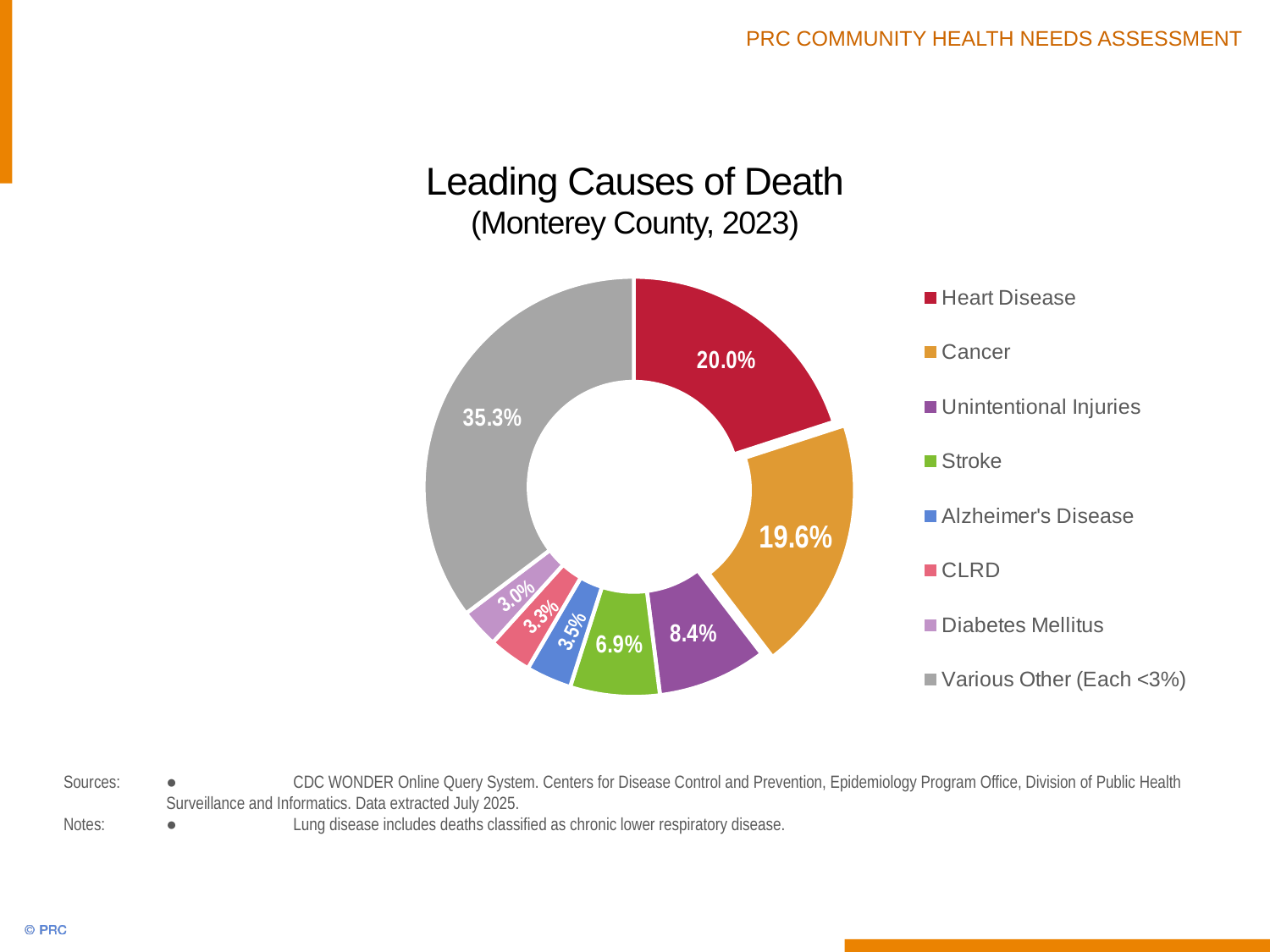
Which category has the largest share of the chart? Various Other (Each <3%) What is the difference between the Heart Disease share and the Cancer share? 0.4% What share of deaths is attributed to Heart Disease? 20.0% What percentage of deaths is attributed to Cancer? 19.6% What percentage is shown for Alzheimer's Disease? 3.5% What percentage is shown for Diabetes Mellitus? 3.0% Which is larger, the share for Unintentional Injuries or the share for Stroke? Unintentional Injuries What share of deaths is attributed to Stroke? 6.9% How many categories does the legend list? 8 What kind of chart is shown on the slide? Doughnut chart Which named cause of death has the smallest share? Diabetes Mellitus What is the title of the chart? Leading Causes of Death (Monterey County, 2023)